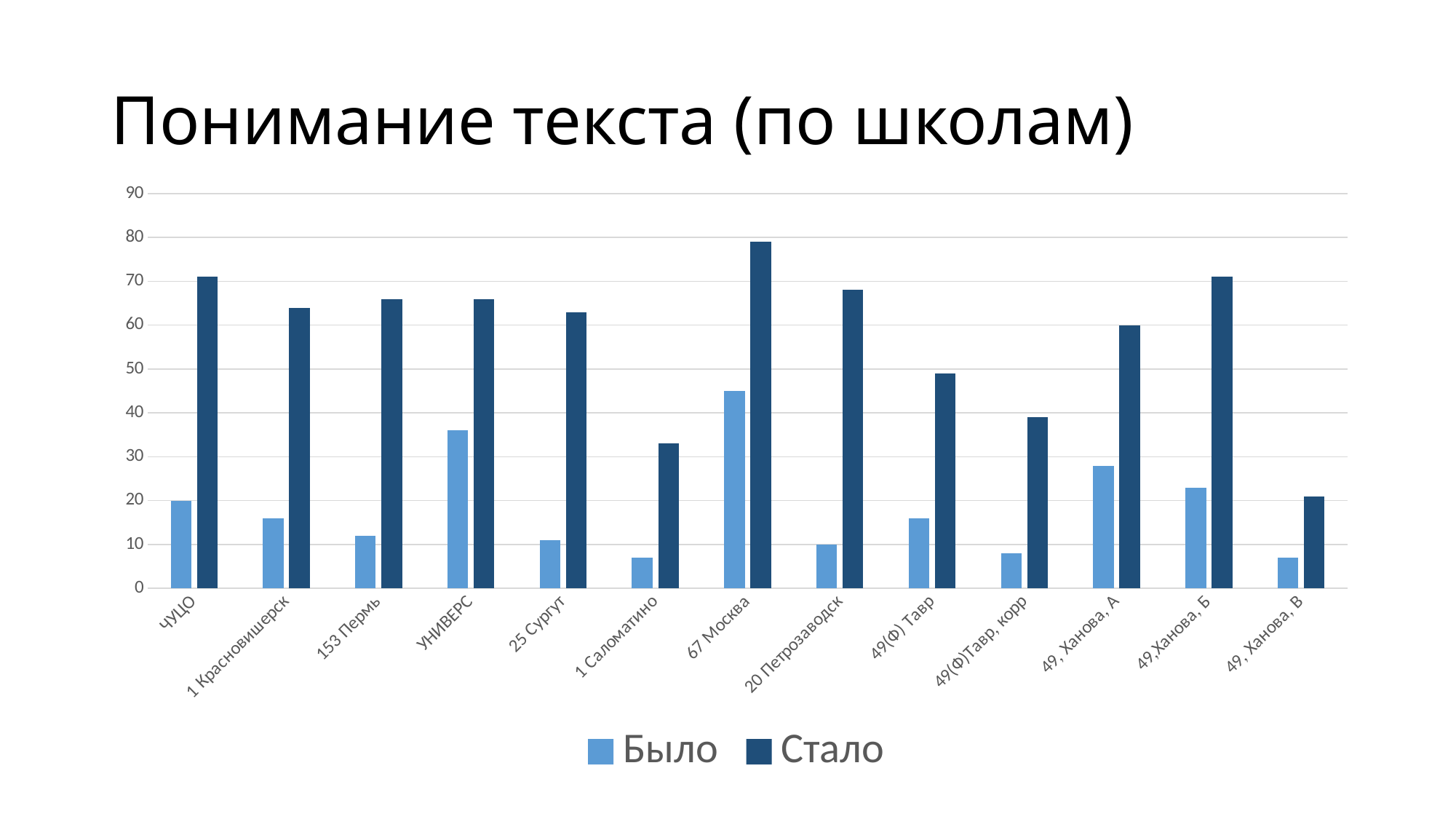
How many schools (categories) are shown on the x axis? 13 Is the Стало value for 67 Москва greater or less than 70? greater Is the Было value for 153 Пермь greater or less than 20? less Which school has the highest value for Стало? 67 Москва What kind of chart is shown on the slide? bar chart Is the Было value for УНИВЕРС greater or less than 30? greater What is the title of the chart? Понимание текста (по школам) Which school has the highest value for Было? 67 Москва How many series does the legend list? 2 Which is larger: the Стало value for 67 Москва or for 20 Петрозаводск? 67 Москва Which school has the lowest value for Стало? 49, Ханова, В